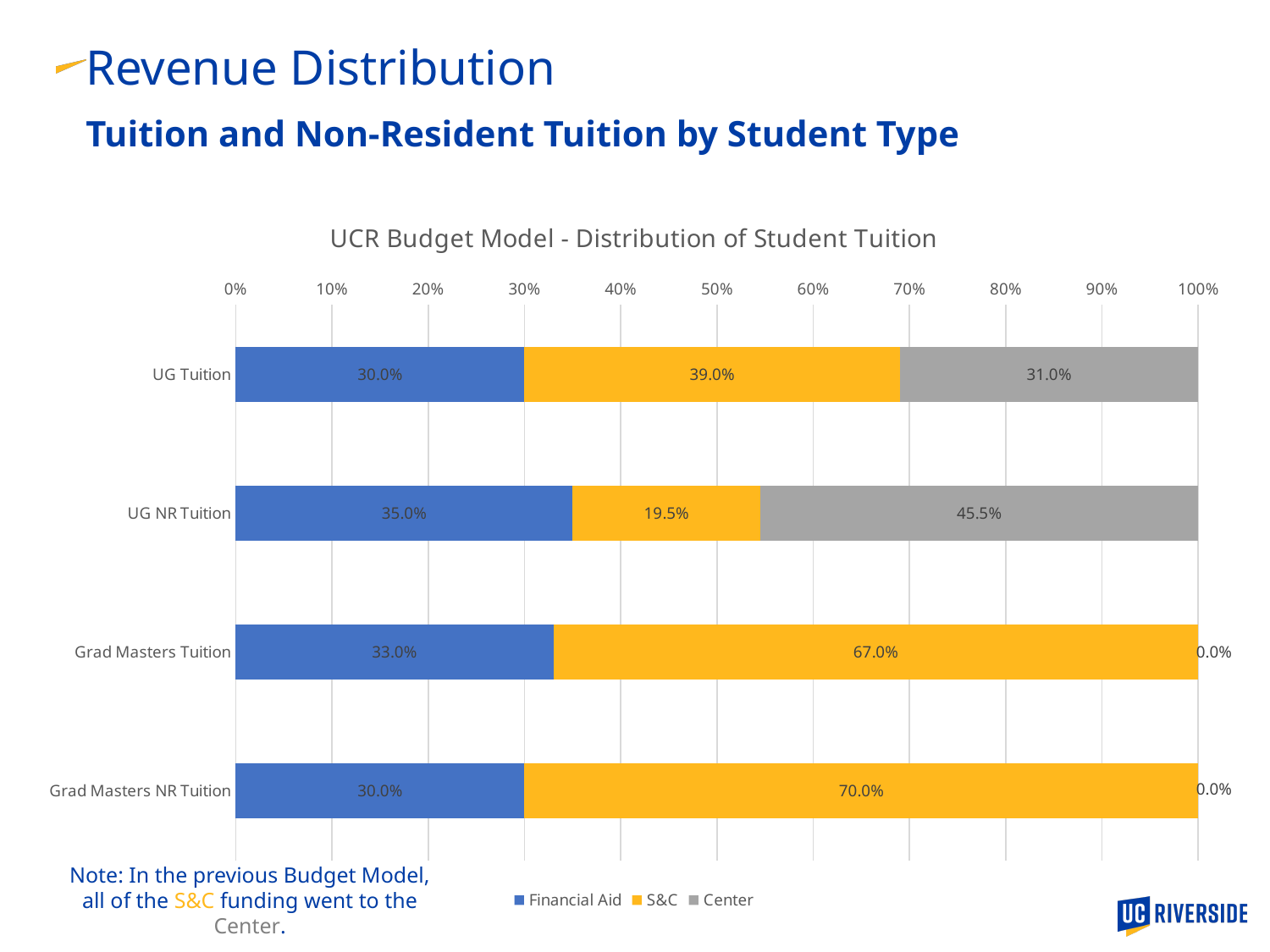
How many series does the legend list? 3 How many student tuition categories are shown on the chart? 4 What is the Center share for UG NR Tuition? 45.5% What is the S&C share for Grad Masters NR Tuition? 70.0% What is the difference between the Center share for UG NR Tuition and for UG Tuition? 14.5% What kind of chart is shown? Stacked bar chart What is the Financial Aid share for UG Tuition? 30.0% What is the title of the chart? UCR Budget Model - Distribution of Student Tuition What is the Center share for Grad Masters Tuition? 0.0% Which is larger, the Financial Aid share for UG NR Tuition or for Grad Masters Tuition? UG NR Tuition Which category has the lowest S&C share? UG NR Tuition Which category has the highest S&C share? Grad Masters NR Tuition